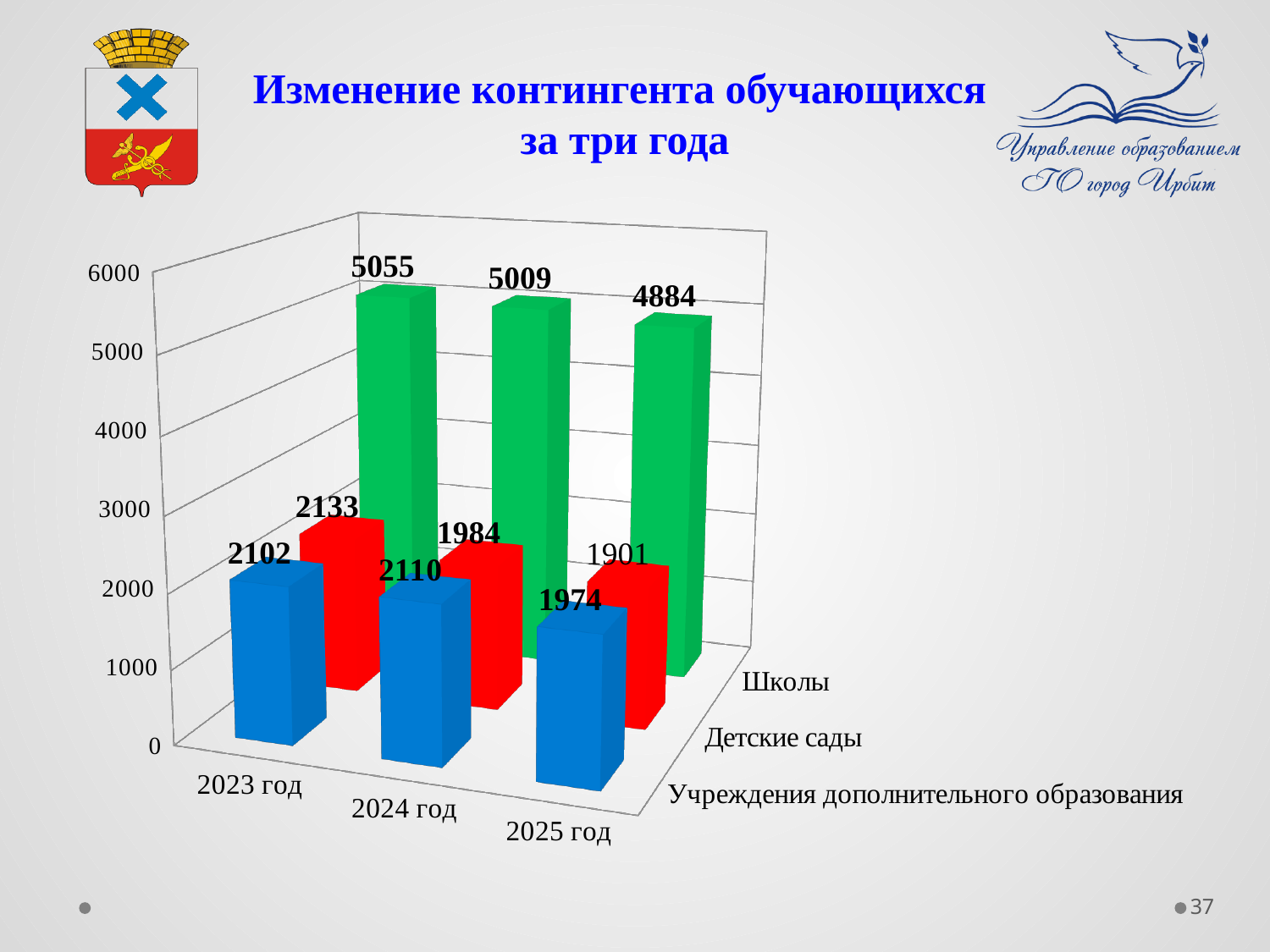
Do the values for Школы rise or fall from 2023 год to 2025 год? fall How many years are shown on the chart? 3 In which year is the value for Детские сады the highest? 2023 год What is the value for Школы in 2025 год? 4884 What type of chart is shown on the slide? bar chart How many data series are plotted on the chart? 3 In which year is the value for Школы the lowest? 2025 год What is the value for Учреждения дополнительного образования in 2025 год? 1974 What is the difference between the Школы values for 2023 год and 2025 год? 171 What is the value for Школы in 2023 год? 5055 What is the value for Детские сады in 2024 год? 1984 Which is larger: Детские сады in 2023 год or Учреждения дополнительного образования in 2023 год? Детские сады